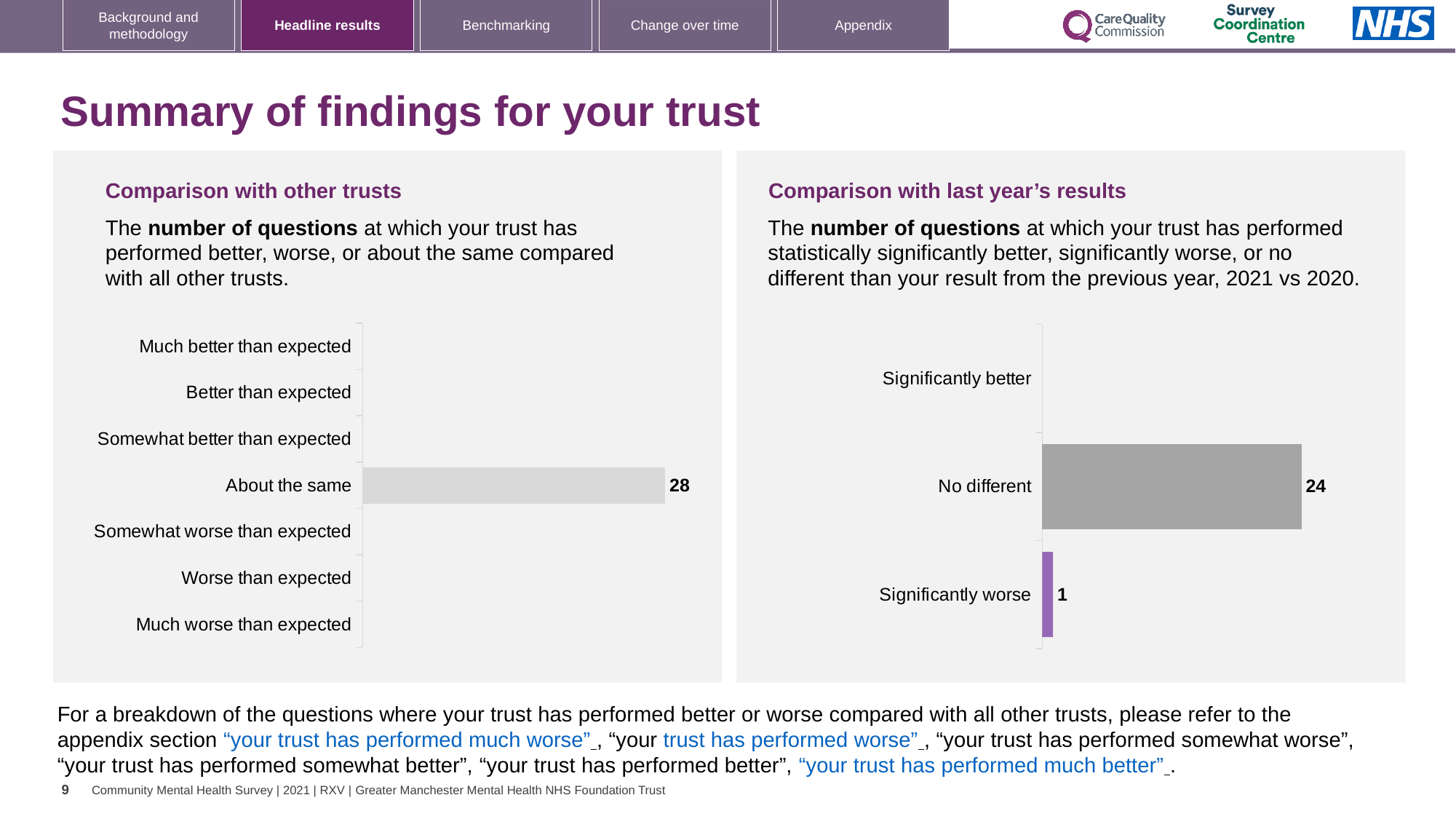
In the 'Comparison with other trusts' chart, which category has the highest value? About the same In the 'Comparison with last year's results' chart, what is the value for 'No different'? 24 How many categories are listed on the axis of the 'Comparison with last year's results' chart? 3 In the 'Comparison with last year's results' chart, what is the value for 'Significantly worse'? 1 What is the title of the chart on the right side of the slide? Comparison with last year's results In the 'Comparison with last year's results' chart, which category has the highest value? No different In the 'Comparison with last year's results' chart, what is the difference between 'No different' and 'Significantly worse'? 23 How many categories are listed on the axis of the 'Comparison with other trusts' chart? 7 In the 'Comparison with other trusts' chart, what is the value for 'About the same'? 28 What type of chart is the 'Comparison with other trusts' chart? Bar chart In the 'Comparison with last year's results' chart, what colour is the 'Significantly worse' bar? Purple In the 'Comparison with last year's results' chart, which is larger: 'No different' or 'Significantly worse'? No different